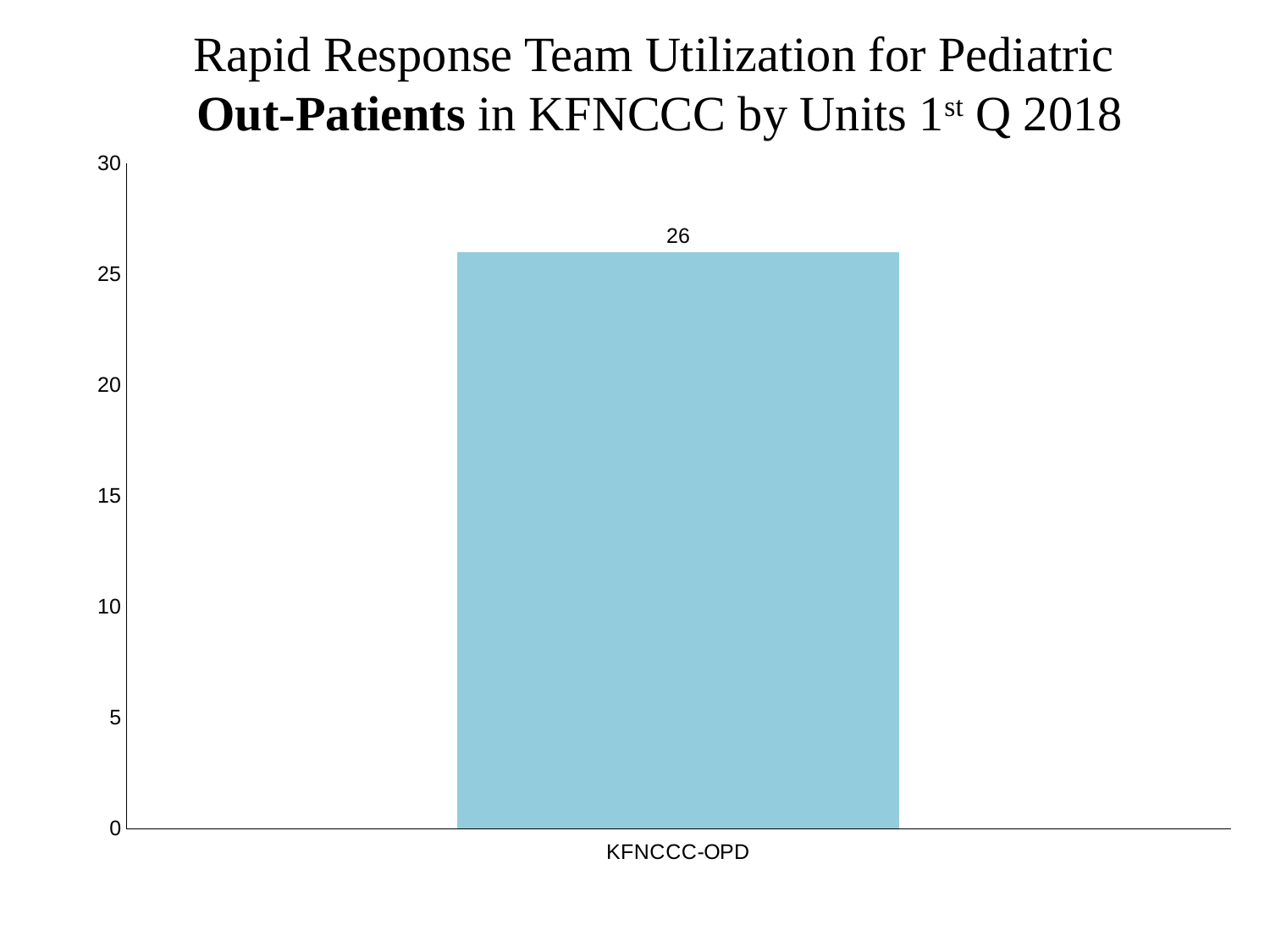
What is the maximum value shown on the y axis? 30 What is the value for KFNCCC-OPD? 26 How many categories are shown on the x axis? 1 Is the value for KFNCCC-OPD greater or less than 25? greater What is the label of the single category on the x axis? KFNCCC-OPD Is the value for KFNCCC-OPD greater or less than 30? less What kind of chart is shown on the slide? bar chart